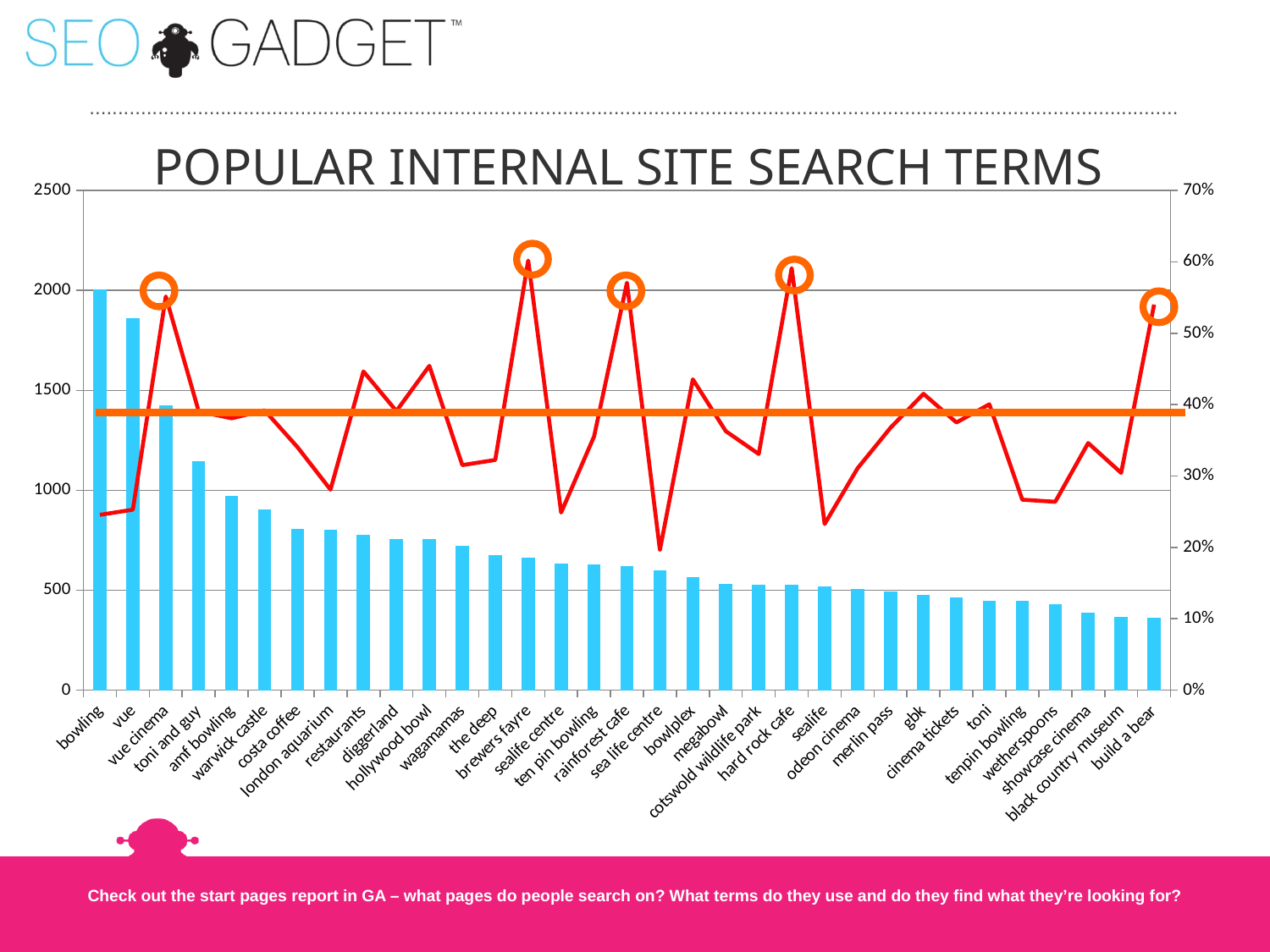
Is the bar value for toni and guy greater or less than 1000? greater How many search terms are shown along the x axis? 33 Is the bar value for warwick castle greater or less than 1000? less Do the bar values rise or fall moving from left to right along the x axis? Fall How many orange circles highlight points on the red line? 5 Is the red line value for sea life centre greater or less than 30%? less Which has the larger bar, vue or vue cinema? vue Which search term has the tallest bar? bowling What kind of chart is shown on the slide? A bar chart combined with a line chart What is the title of the chart? POPULAR INTERNAL SITE SEARCH TERMS